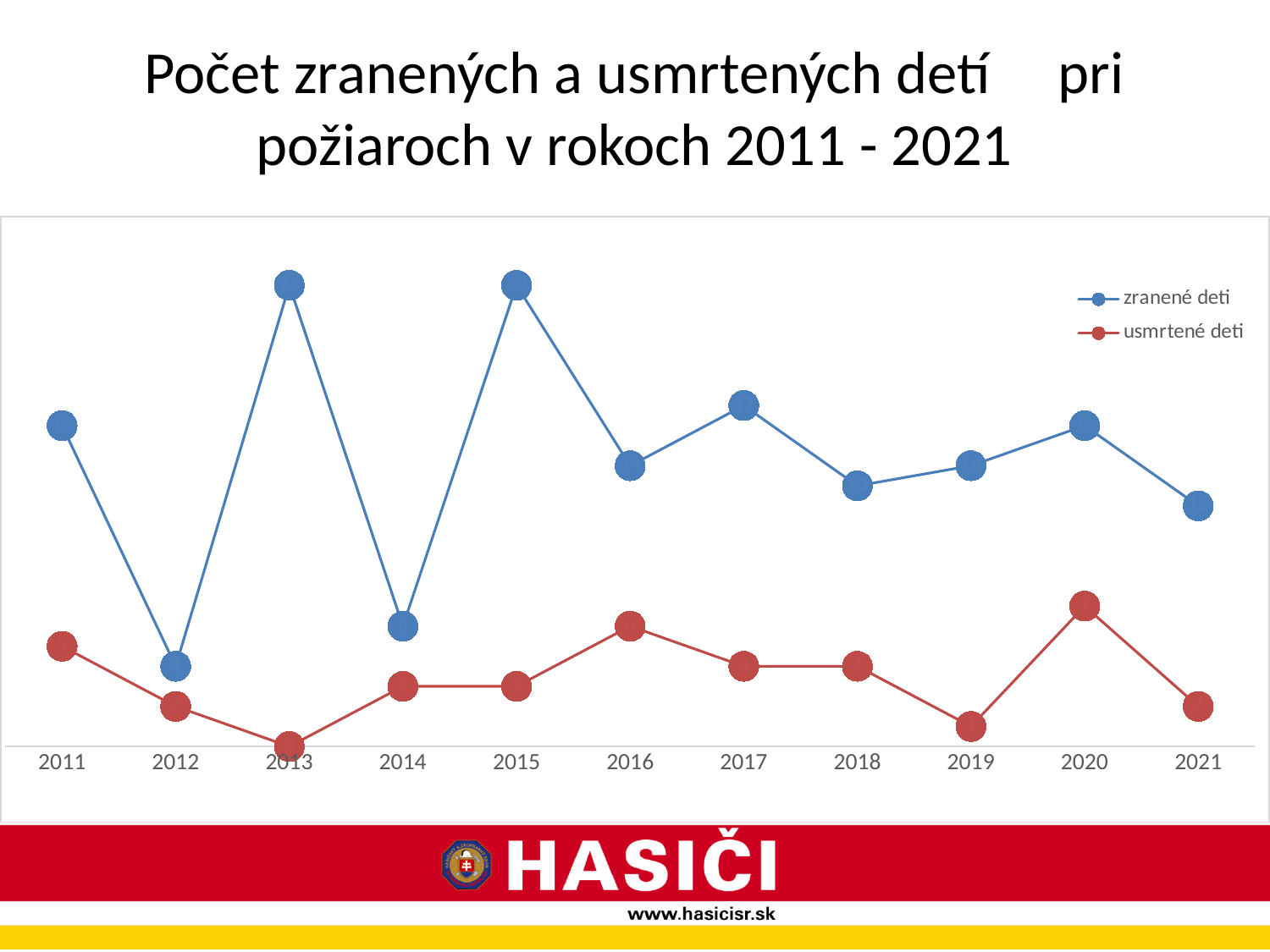
Which year has the larger value for zranené deti, 2011 or 2012? 2011 Which year has the larger value for usmrtené deti, 2016 or 2019? 2016 What are the two series named in the legend? zranené deti and usmrtené deti In which year is the value for zranené deti lowest? 2012 How many years are plotted along the x axis? 11 In which year is the value for usmrtené deti highest? 2020 What kind of chart is shown on the slide? line chart Does the value for zranené deti rise or fall from 2017 to 2018? fall In 2021, which series has the higher value, zranené deti or usmrtené deti? zranené deti How many series does the legend list? 2 In which year is the value for usmrtené deti lowest? 2013 Does the value for usmrtené deti rise or fall from 2019 to 2020? rise